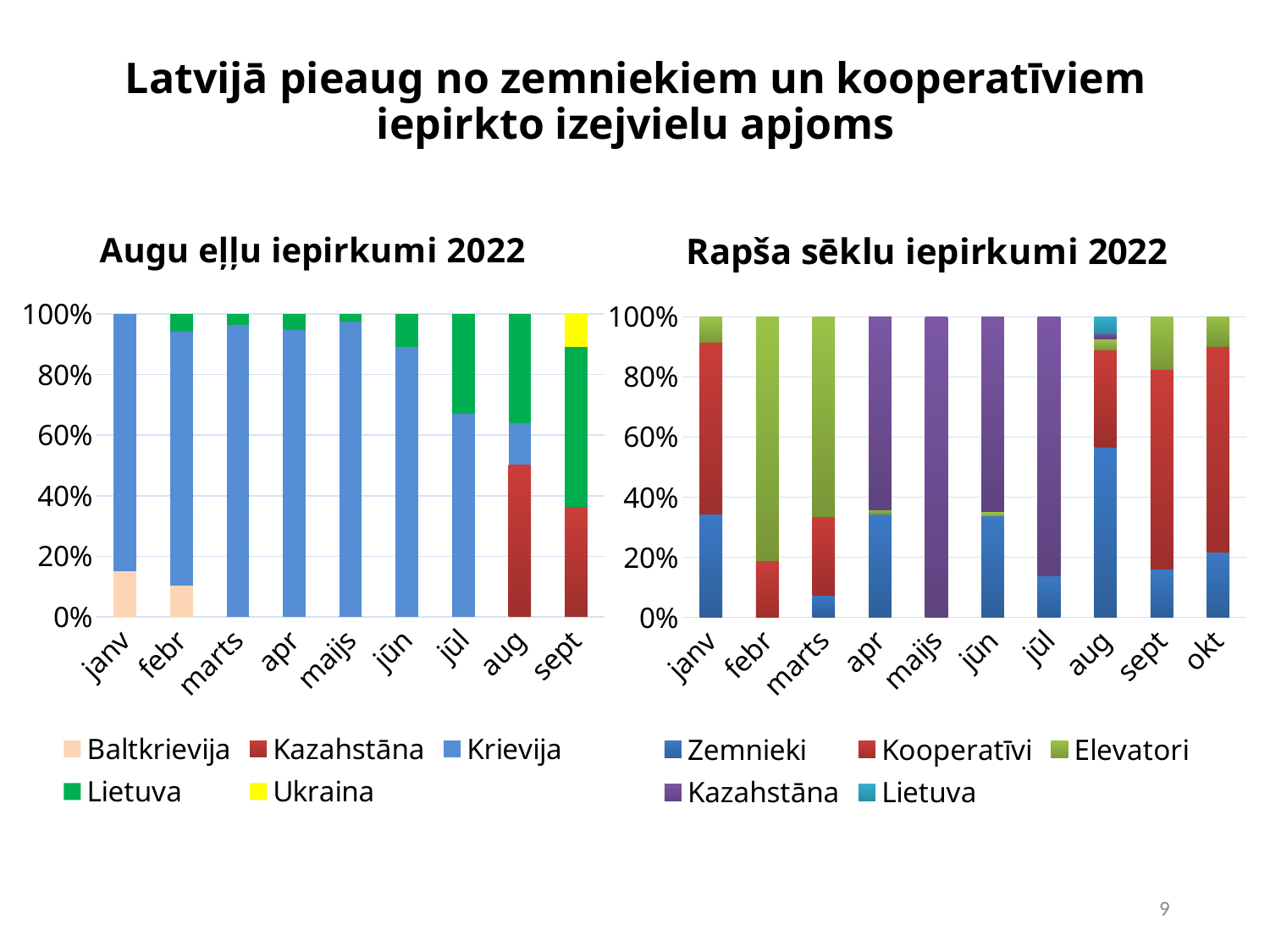
How many series does the legend of the 'Rapša sēklu iepirkumi 2022' chart list? 5 In the 'Rapša sēklu iepirkumi 2022' chart, is the share for Zemnieki in aug greater or less than 40%? greater In the 'Augu eļļu iepirkumi 2022' chart, is the share for Krievija in janv greater or less than 80%? greater In the 'Rapša sēklu iepirkumi 2022' chart, which month's bar consists entirely of Kazahstāna? maijs What kind of chart is the 'Augu eļļu iepirkumi 2022' chart? stacked bar chart How many months are shown on the x axis of the 'Augu eļļu iepirkumi 2022' chart? 9 How many series does the legend of the 'Augu eļļu iepirkumi 2022' chart list? 5 How many months are shown on the x axis of the 'Rapša sēklu iepirkumi 2022' chart? 10 In the 'Rapša sēklu iepirkumi 2022' chart, is the share for Zemnieki in jūl greater or less than 20%? less In the 'Augu eļļu iepirkumi 2022' chart, in which month does Ukraina appear? sept